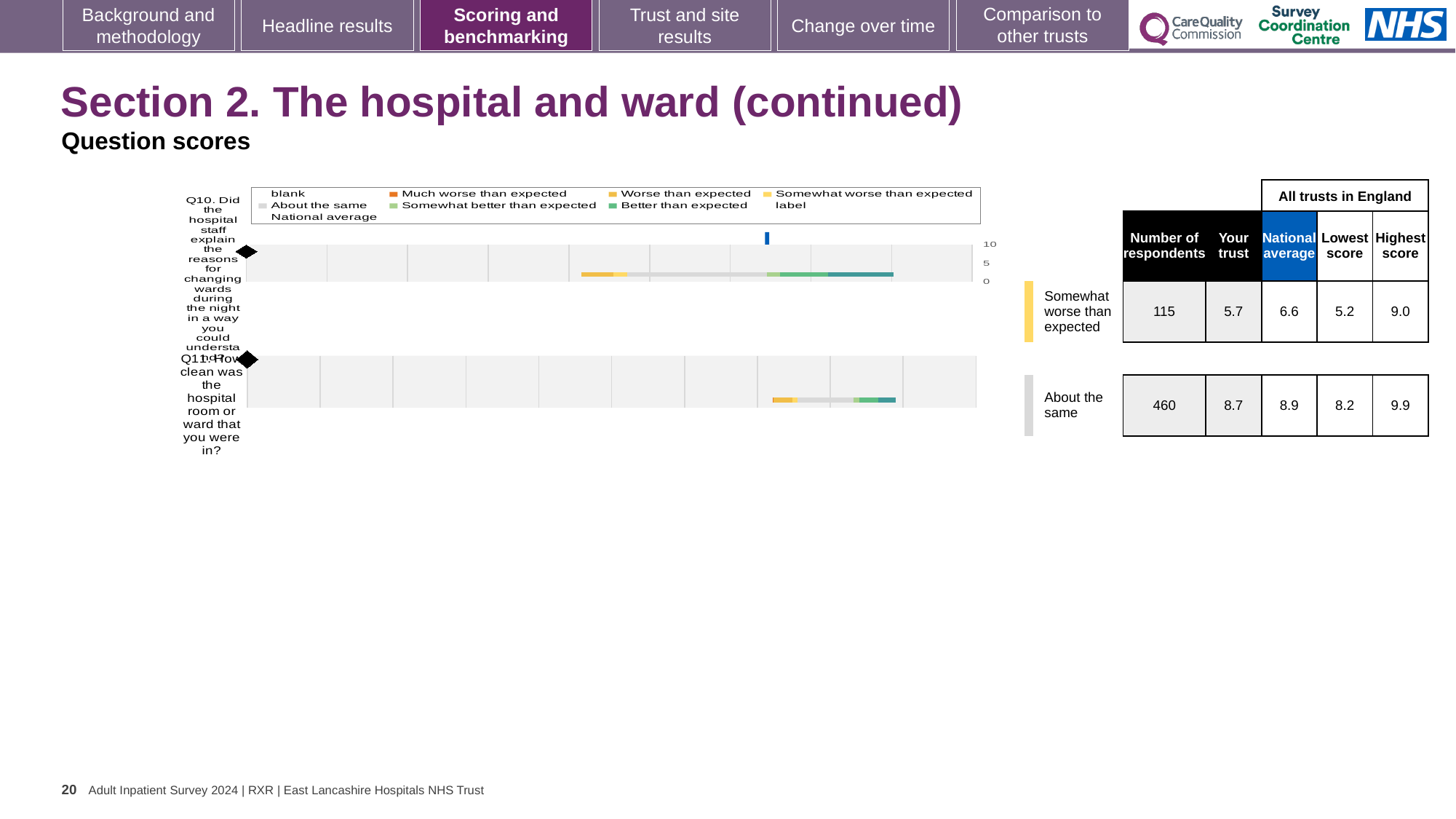
What is the 'Your trust' score for Q11 (how clean was the hospital room or ward)? 8.7 What is the highest score across all trusts in England for Q11? 9.9 What is the national average score for Q10? 6.6 Which benchmark category is Q11 placed in? About the same What kind of chart is used to show the question scores for Q10 and Q11? bar chart What is the difference between the highest score and the lowest score across all trusts in England for Q10? 3.8 What is the difference between the national average and the 'Your trust' score for Q10? 0.9 What is the 'Your trust' score for Q10 (explaining reasons for changing wards during the night)? 5.7 Which benchmark category is Q10 placed in? Somewhat worse than expected How many questions are plotted in the chart? 2 Which question has the higher 'Your trust' score, Q10 or Q11? Q11 How many respondents answered Q11? 460